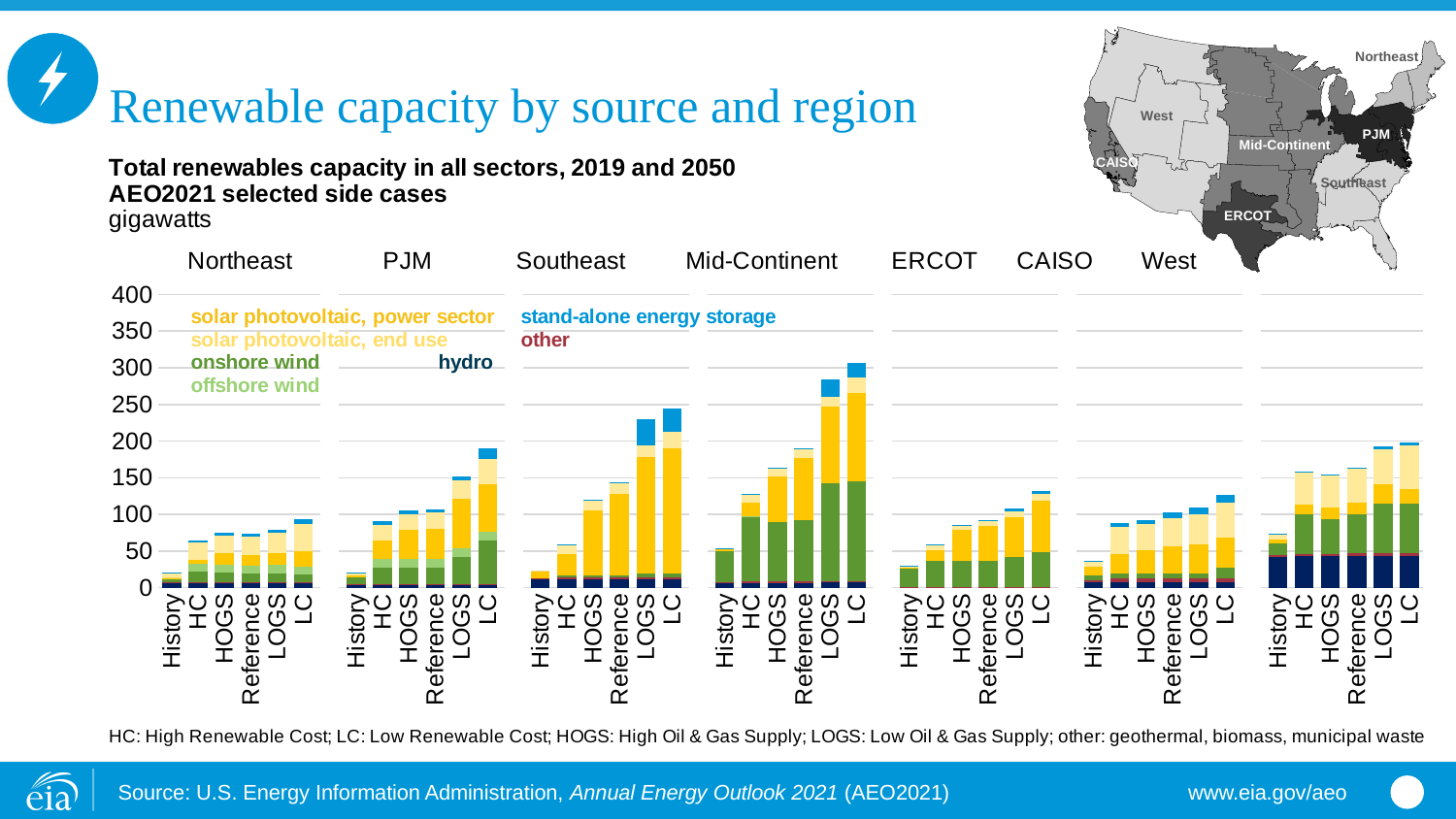
Which is larger, the LC bar for Northeast or the LC bar for PJM? PJM Which region has the tallest LC bar? Mid-Continent In the Mid-Continent panel, do the bars rise or fall from History to LC? rise How many regions are shown in the chart? 7 How many bars are plotted for each region? 6 Is the value of the LC bar for West greater or less than 150? greater Is the value of the LC bar for Mid-Continent greater or less than 250? greater What unit is the chart measured in? gigawatts What kind of chart is shown on the slide? stacked bar chart How many renewable source categories does the legend list? 7 Is the value of the History bar for ERCOT greater or less than 50? less